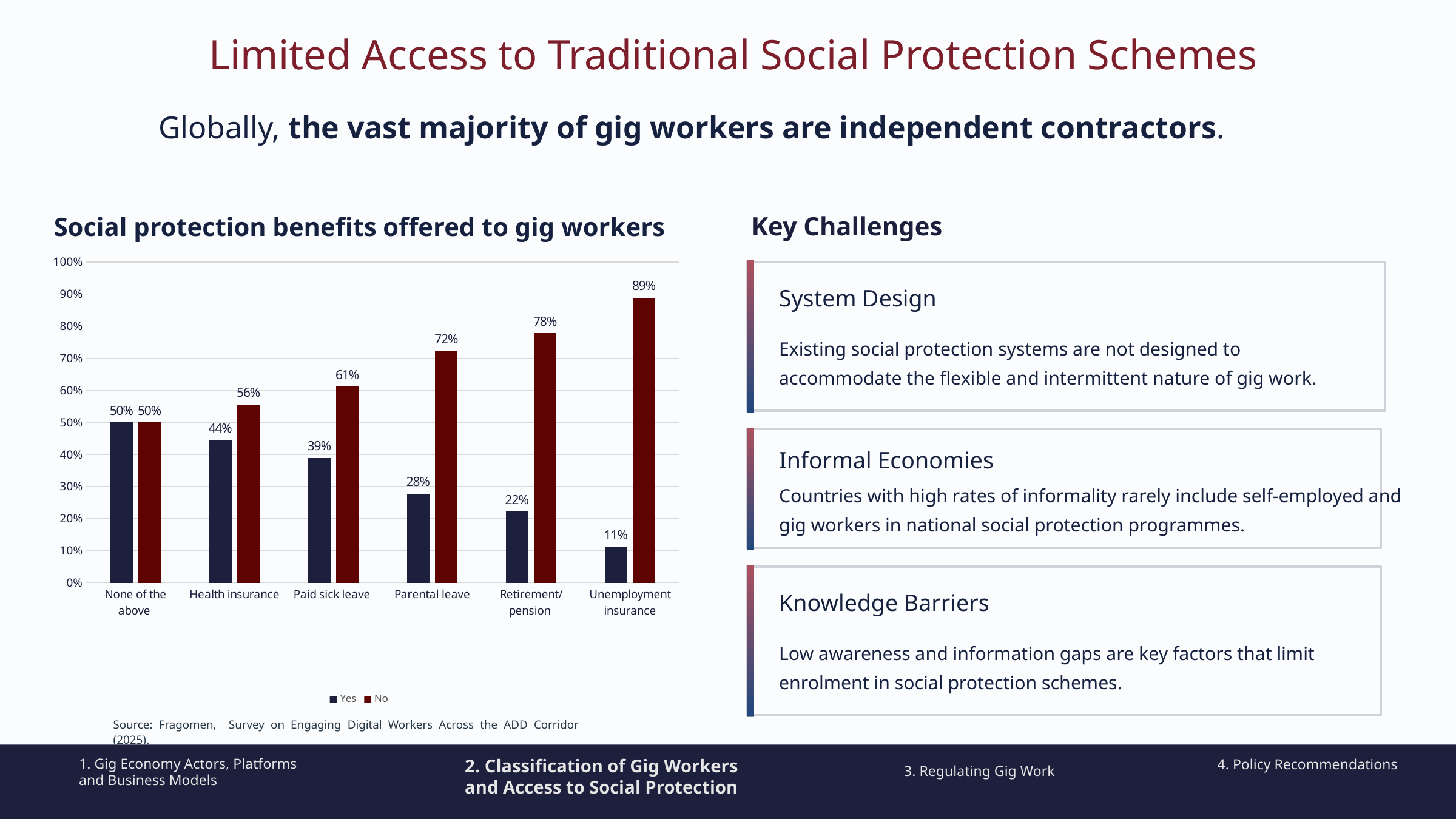
What is the difference between the 'No' and 'Yes' values for Parental leave? 44% How many series does the legend list? 2 What is the 'No' value for Unemployment insurance? 89% Which category has the lowest 'Yes' value? Unemployment insurance What is the 'Yes' value for Health insurance? 44% Which is larger, the 'Yes' value for Paid sick leave or the 'Yes' value for Health insurance? Health insurance What is the 'Yes' value for Retirement/pension? 22% Which category has the highest 'No' value? Unemployment insurance How many categories are shown on the x axis? 6 What kind of chart is shown? Bar chart What are the two series listed in the legend? Yes and No What is the title of the chart? Social protection benefits offered to gig workers